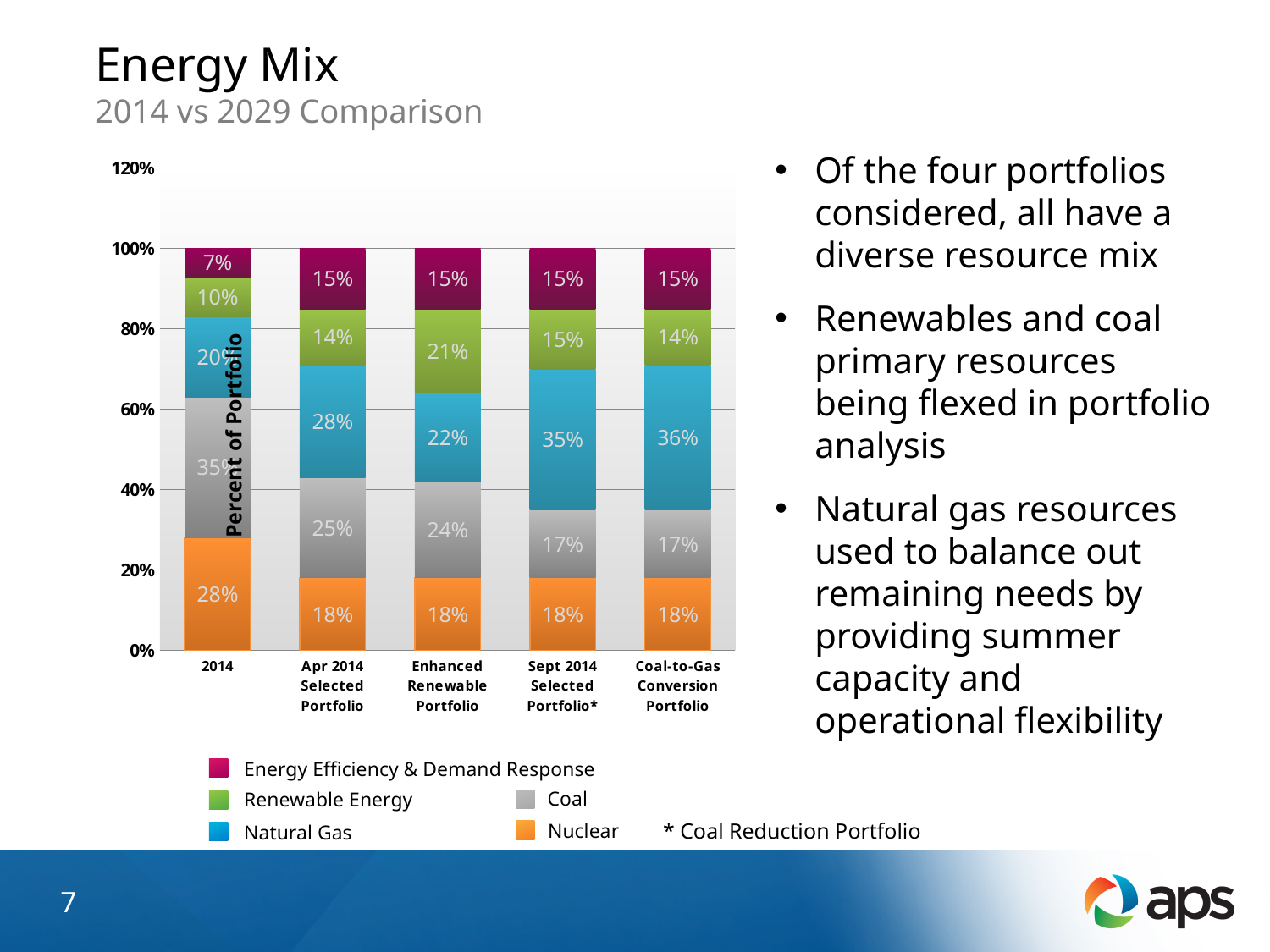
What is the Renewable Energy share in the Enhanced Renewable Portfolio? 21% What is the title of the chart's vertical axis? Percent of Portfolio Which bar has the lowest Energy Efficiency & Demand Response share? 2014 What kind of chart is shown on the slide? Stacked bar chart Which has a larger Renewable Energy share, the Apr 2014 Selected Portfolio or the Enhanced Renewable Portfolio? Enhanced Renewable Portfolio What is the Natural Gas share in the Coal-to-Gas Conversion Portfolio? 36% What is the Coal share in the Enhanced Renewable Portfolio? 24% How many series does the chart's legend list? 5 What is the difference in Coal share between the Apr 2014 Selected Portfolio and the Sept 2014 Selected Portfolio*? 8 percentage points What is the Nuclear share in the 2014 bar? 28% Which portfolio has the highest Natural Gas share? Coal-to-Gas Conversion Portfolio How many portfolios (categories) are shown along the x axis of the chart? 5